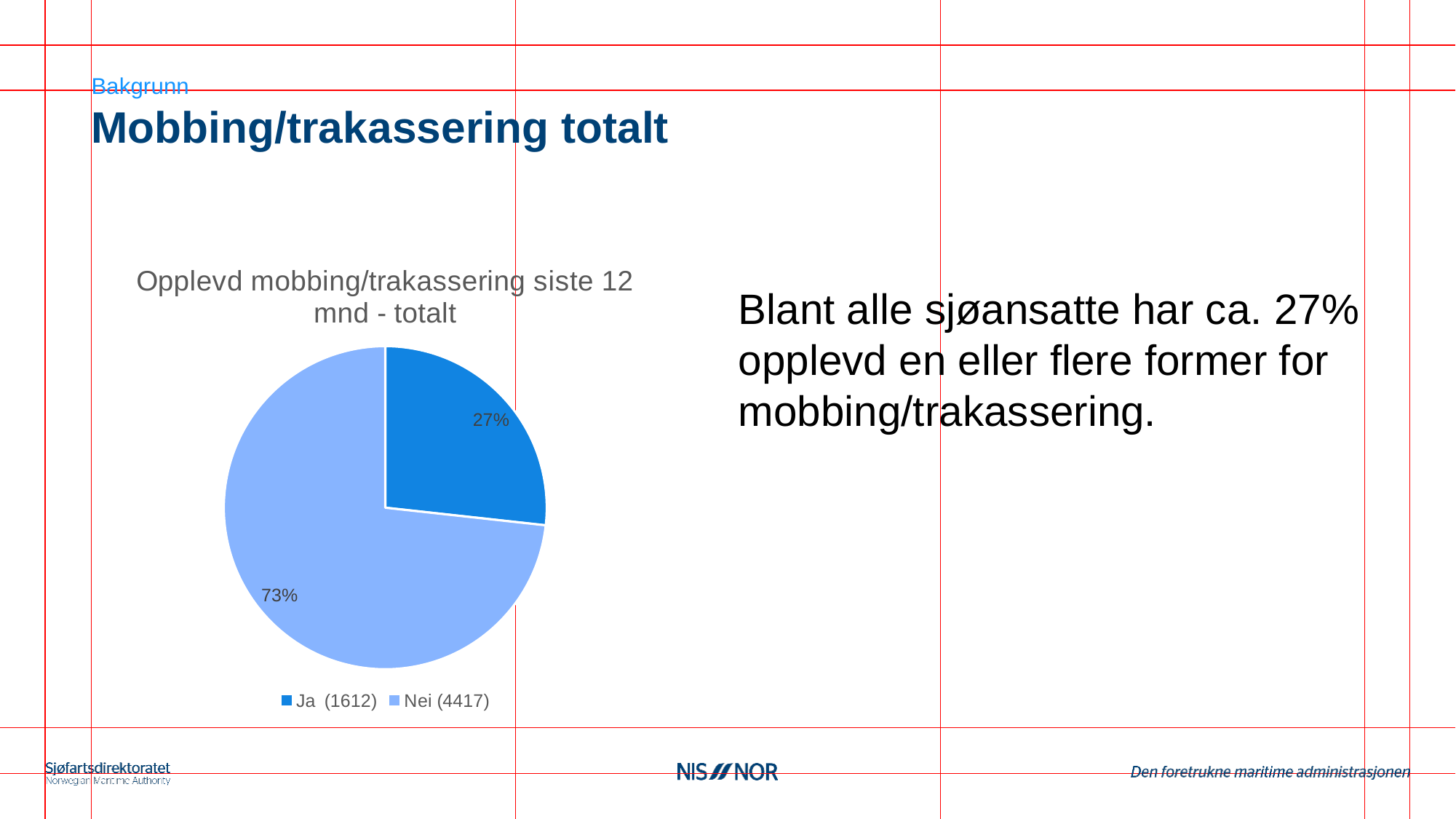
What count is shown in the legend for "Nei"? 4417 What percentage of the pie is the "Ja" slice? 27% How many slices does the pie chart have? 2 What percentage of the pie is the "Nei" slice? 73% Which slice is the smallest in the pie chart? Ja How many entries does the legend list? 2 What count is shown in the legend for "Ja"? 1612 Which slice is the largest in the pie chart? Nei What kind of chart is shown on the slide? pie chart Which slice is larger, "Ja" or "Nei"? Nei What is the difference in percentage points between the "Nei" and "Ja" slices? 46 What is the title of the chart? Opplevd mobbing/trakassering siste 12 mnd - totalt